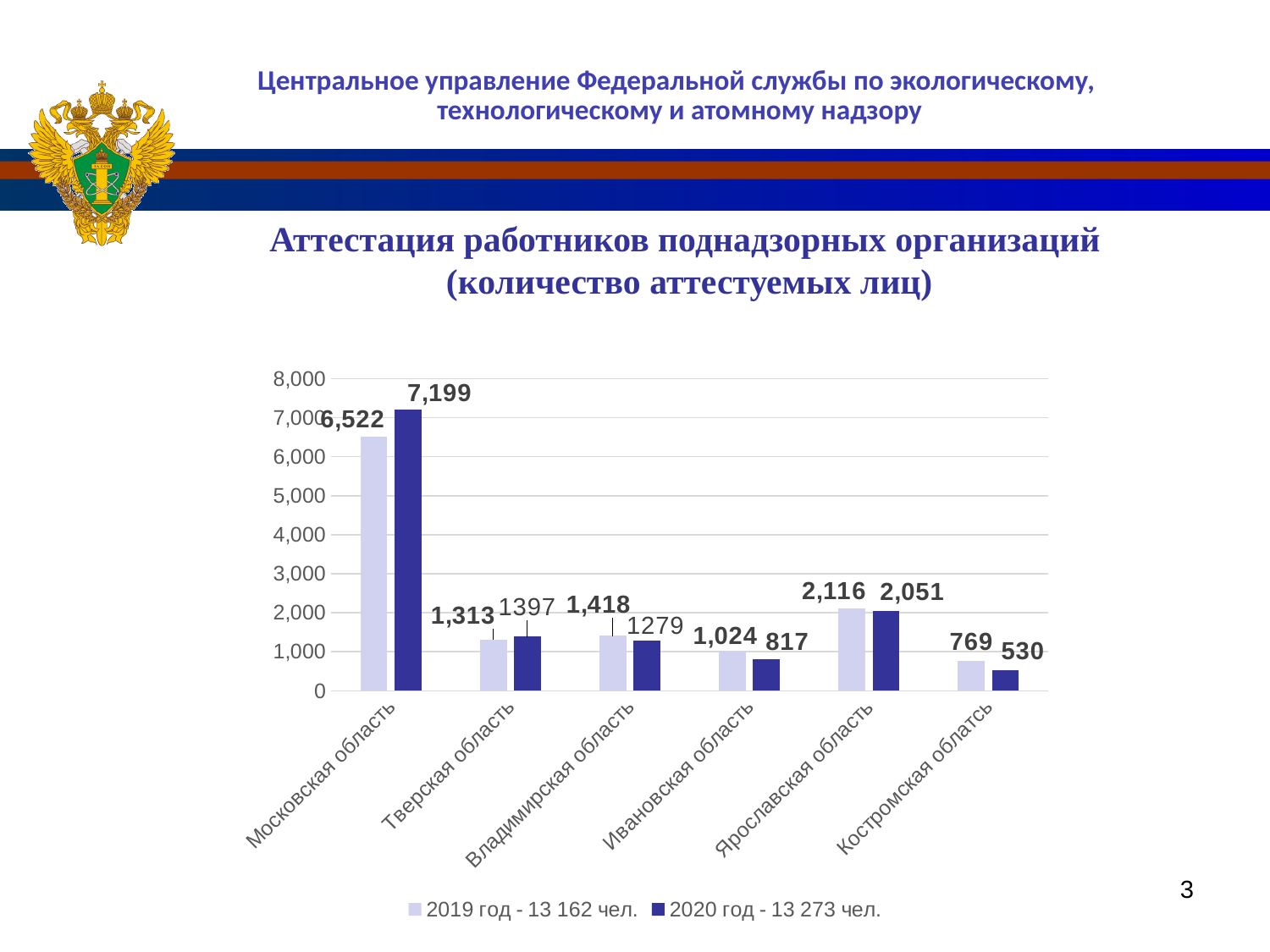
What is the 2020 value for Костромская область? 530 What type of chart is shown on the slide? bar chart Which region has the lowest 2020 value? Костромская область Is the 2019 value for Владимирская область greater or less than 1,000? greater How many series does the legend list? 2 What is the difference between the 2020 and 2019 values for Московская область? 677 How many regions (categories) are shown on the x axis? 6 For Ивановская область, which is larger: the 2019 value or the 2020 value? 2019 value (1,024) What total is given in the legend entry for 2020 год? 13 273 чел. What is the 2020 value for Московская область? 7,199 What is the 2019 value for Ярославская область? 2,116 Which region has the highest 2019 value? Московская область